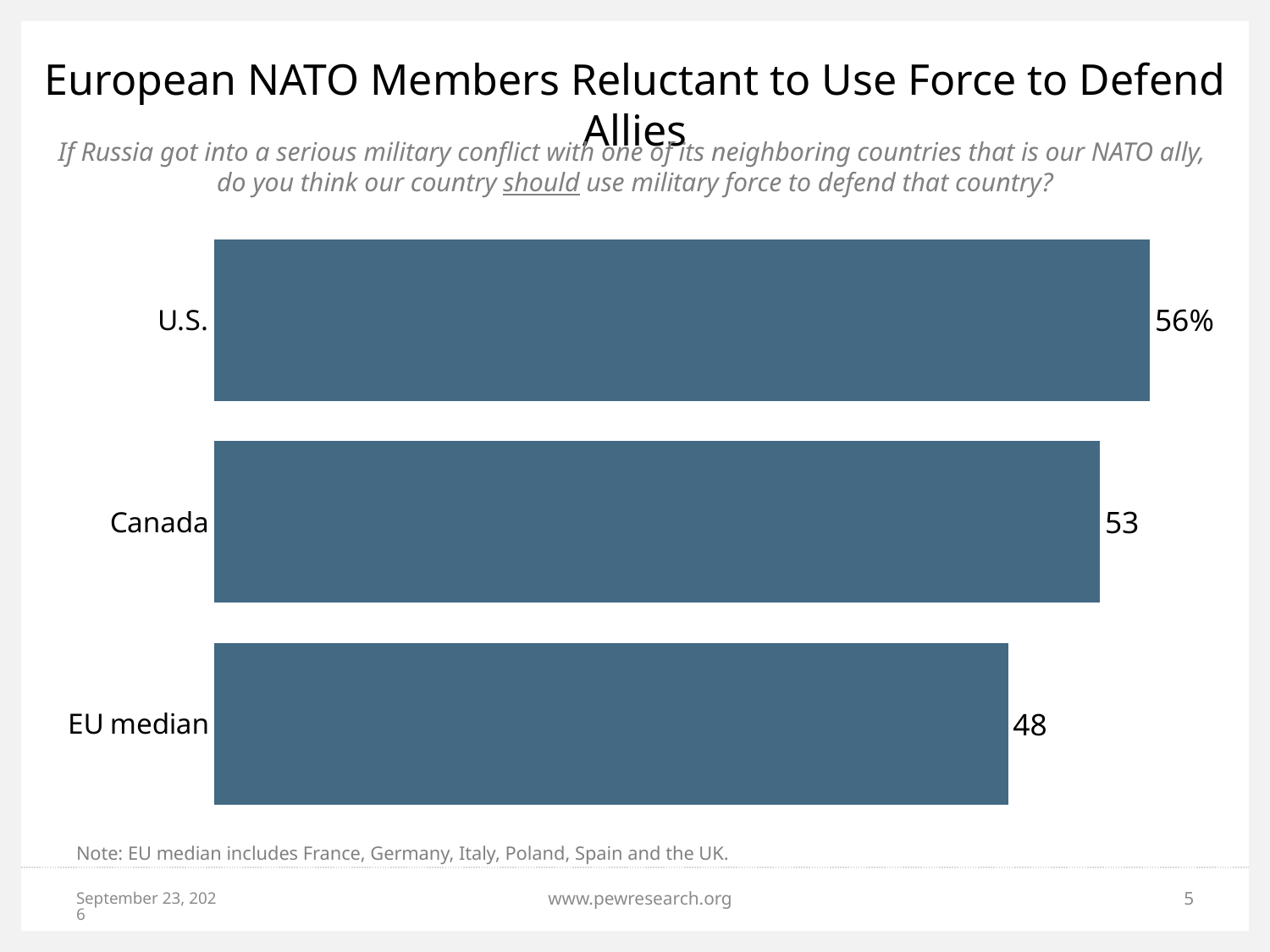
What is the difference between the U.S. value and the EU median value? 8 What is the title of the slide? European NATO Members Reluctant to Use Force to Defend Allies What kind of chart is shown on the slide? Bar chart Which is larger, the value for Canada or the value for EU median? Canada What is the value for the U.S.? 56% What is the value for Canada? 53 What is the difference between the Canada value and the EU median value? 5 Which countries does the note say are included in the EU median? France, Germany, Italy, Poland, Spain and the UK What is the value for EU median? 48 Which category has the lowest value? EU median Which category has the highest value? U.S. How many categories are shown in the chart? 3